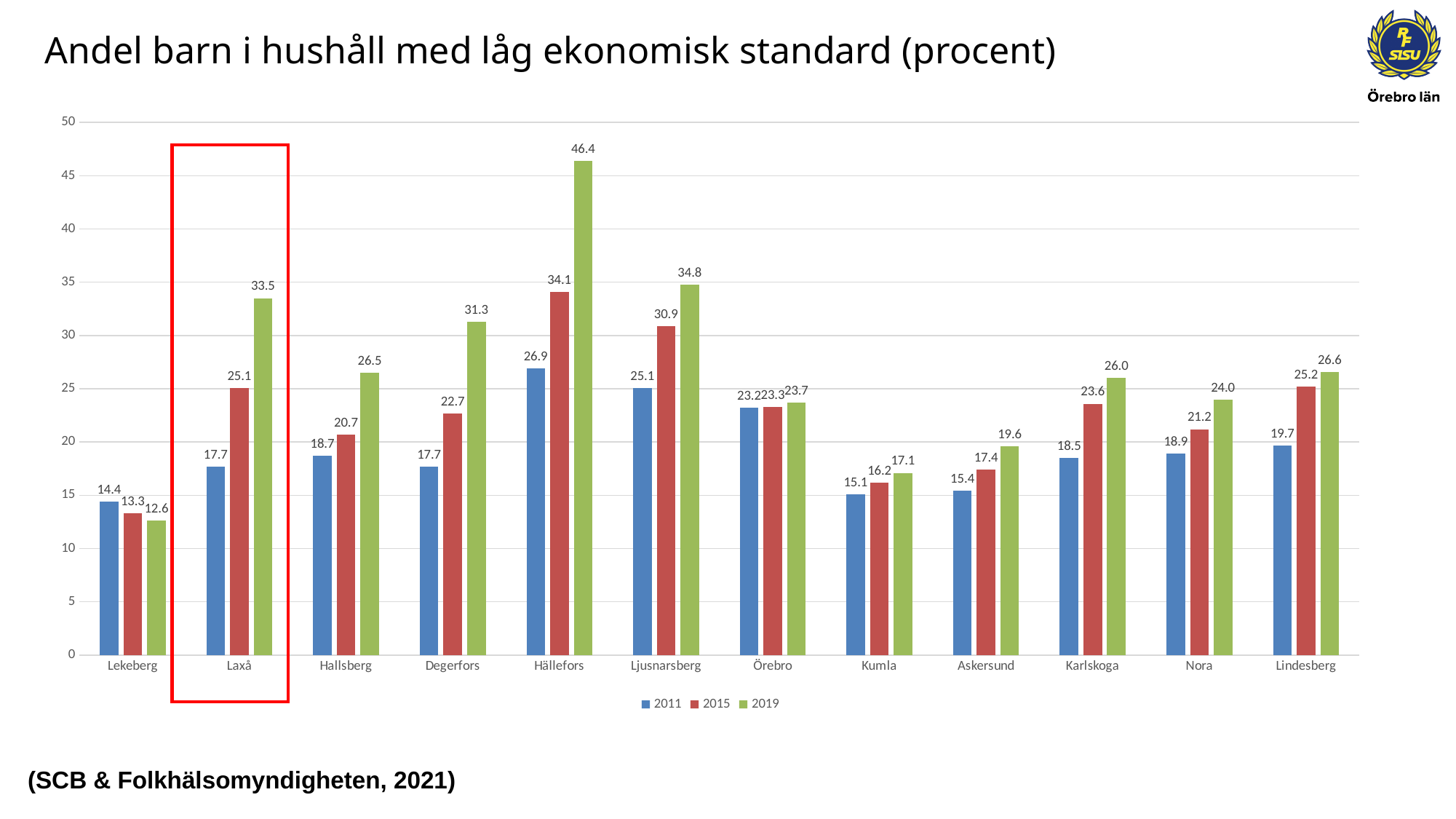
How many municipalities are shown on the x axis? 12 Do the values for Lekeberg rise or fall from 2011 to 2019? fall Which municipality has the highest value in 2019? Hällefors What is the difference between the 2019 and 2015 values for Hällefors? 12.3 What is the difference between the 2019 and 2011 values for Laxå? 15.8 What is the value for Kumla in 2015? 16.2 Which is larger: the 2019 value for Degerfors or the 2019 value for Ljusnarsberg? Ljusnarsberg What is the value for Laxå in 2019? 33.5 What kind of chart is shown on the slide? bar chart Which municipality has the lowest value in 2019? Lekeberg How many series does the legend list? 3 Is the 2019 value for Hällefors greater or less than 45? greater